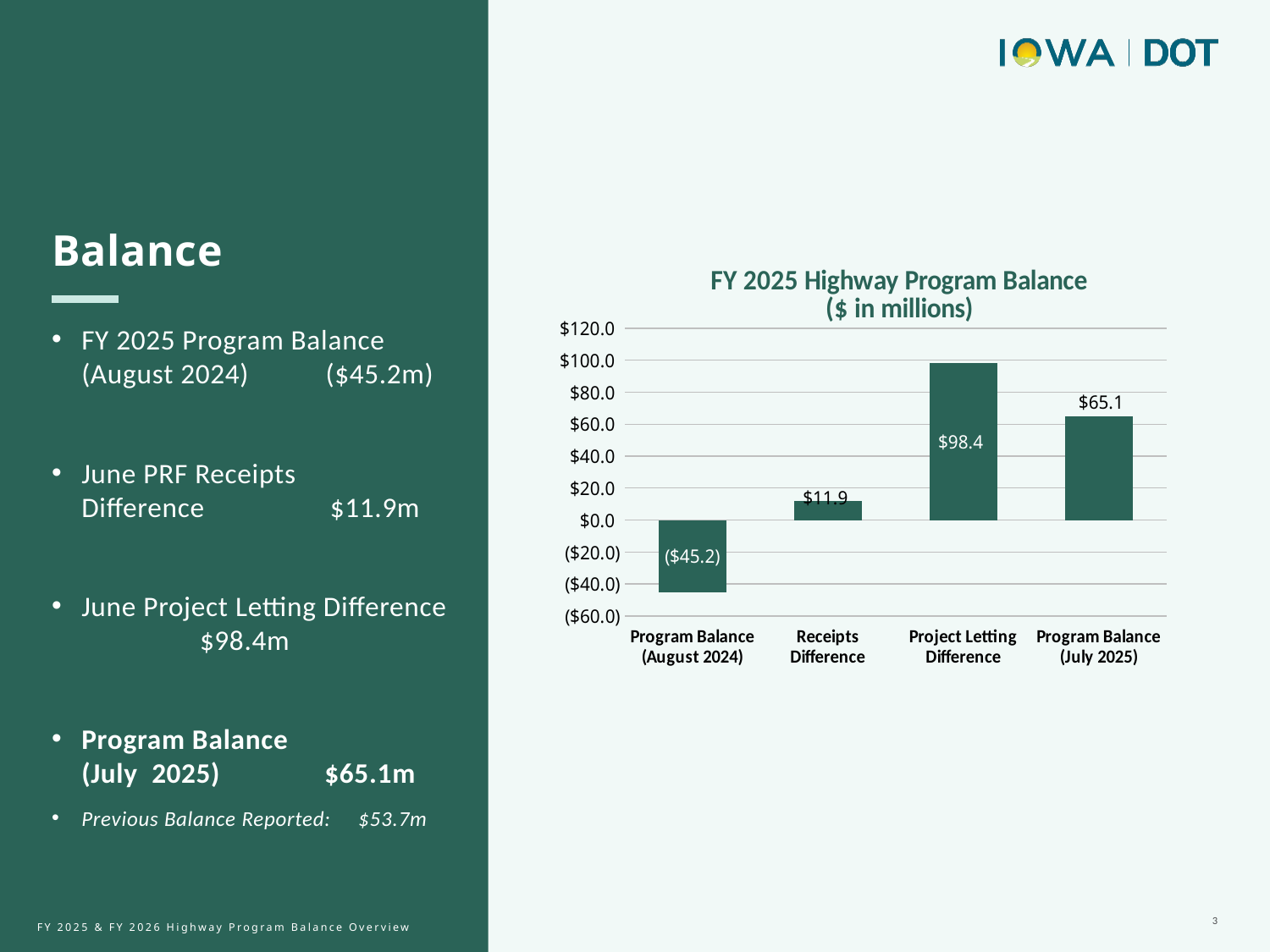
What is the value for Receipts Difference? $11.9 Is the value for Project Letting Difference greater or less than $80.0? greater What is the value for Program Balance (July 2025)? $65.1 Which category has the lowest value? Program Balance (August 2024) What kind of chart is shown on the slide? bar chart What is the title of the chart? FY 2025 Highway Program Balance ($ in millions) Which category has the highest value? Project Letting Difference What is the value for Program Balance (August 2024)? ($45.2) How many categories are shown on the chart? 4 What is the difference between Project Letting Difference and Program Balance (July 2025)? $33.3 What is the value for Project Letting Difference? $98.4 Which is larger, Receipts Difference or Program Balance (July 2025)? Program Balance (July 2025)